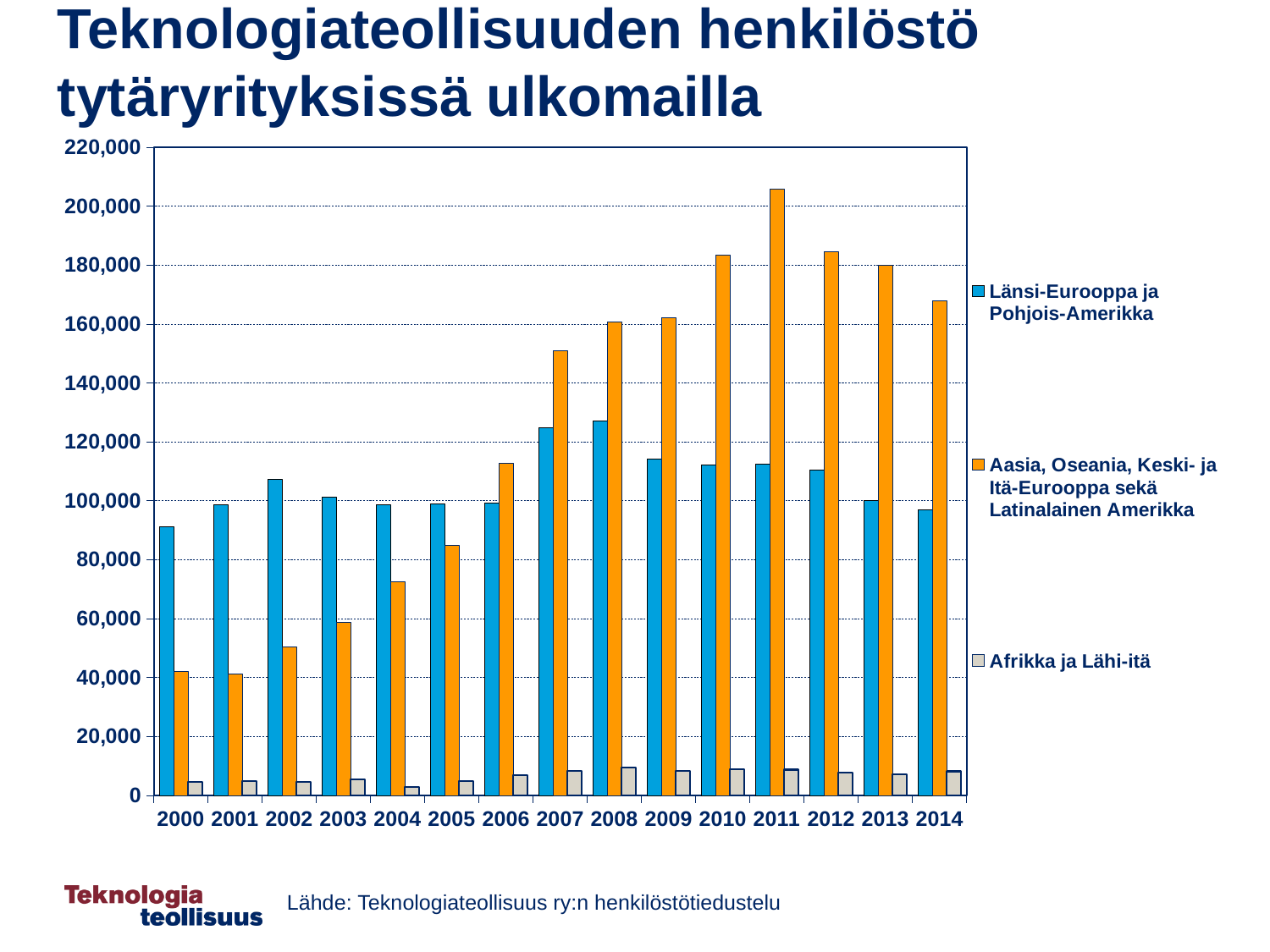
Is the 2004 value for Aasia, Oseania, Keski- ja Itä-Eurooppa sekä Latinalainen Amerikka greater or less than 80,000? less In 2014, which series has the larger value: Länsi-Eurooppa ja Pohjois-Amerikka or Aasia, Oseania, Keski- ja Itä-Eurooppa sekä Latinalainen Amerikka? Aasia, Oseania, Keski- ja Itä-Eurooppa sekä Latinalainen Amerikka In 2000, which series has the larger value: Länsi-Eurooppa ja Pohjois-Amerikka or Aasia, Oseania, Keski- ja Itä-Eurooppa sekä Latinalainen Amerikka? Länsi-Eurooppa ja Pohjois-Amerikka Does the value for Aasia, Oseania, Keski- ja Itä-Eurooppa sekä Latinalainen Amerikka rise or fall from 2005 to 2011? rise In which year is the value for Aasia, Oseania, Keski- ja Itä-Eurooppa sekä Latinalainen Amerikka highest? 2011 How many series does the legend list? 3 How many years are shown on the x axis? 15 Is the 2007 value for Länsi-Eurooppa ja Pohjois-Amerikka greater or less than 120,000? greater Is the 2000 value for Länsi-Eurooppa ja Pohjois-Amerikka greater or less than 100,000? less In which year is the value for Afrikka ja Lähi-itä lowest? 2004 What kind of chart is shown on the slide? Bar chart